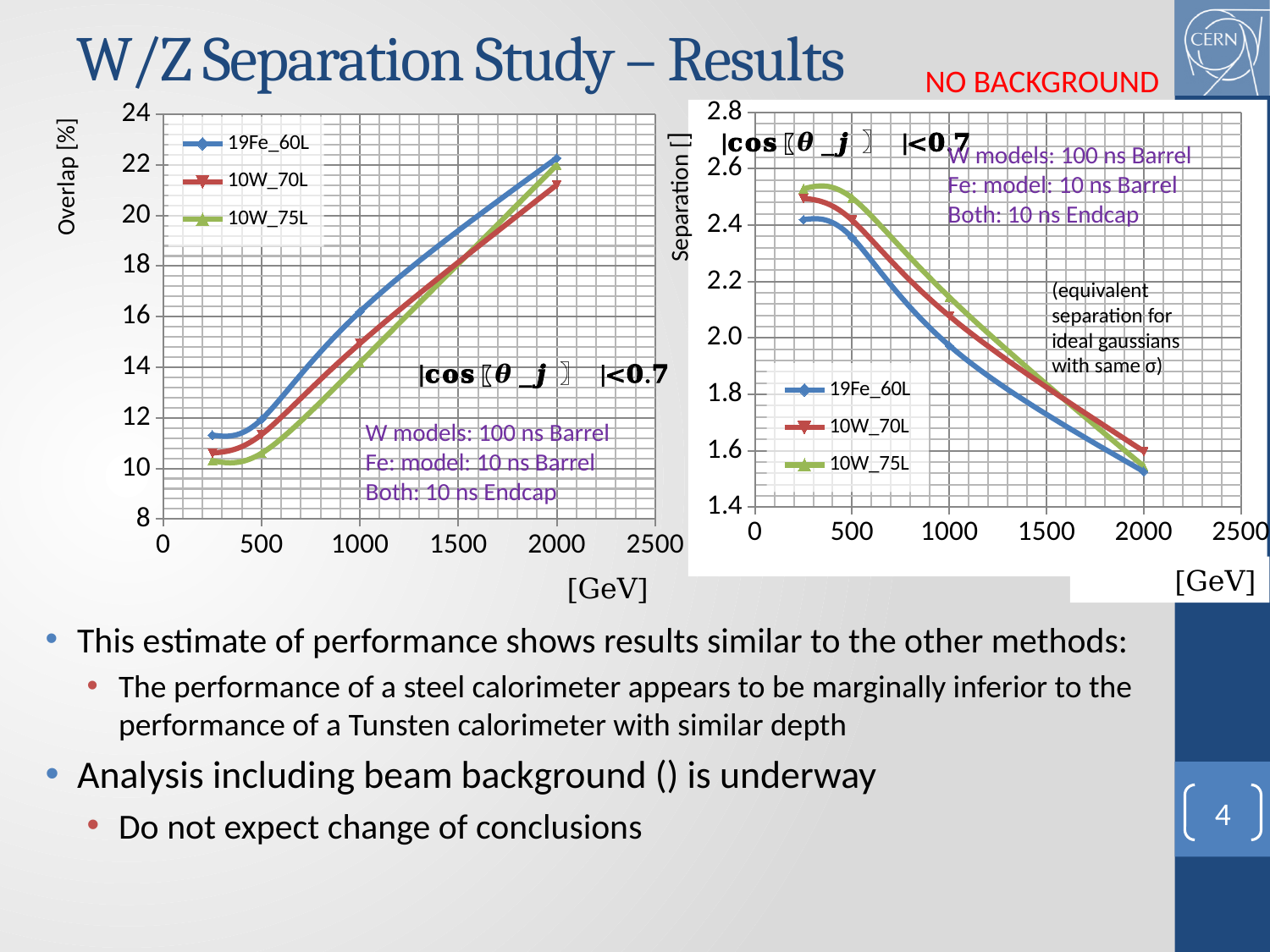
In the right chart (Separation), which series has the lowest value at 250 GeV? 19Fe_60L In the left chart (Overlap [%]), do the values rise or fall as energy in GeV increases? rise What is the y-axis label of the left chart? Overlap [%] In the right chart (Separation), is the value for 10W_70L at 250 GeV greater or less than 2.4? greater In the right chart (Separation), is the value for 19Fe_60L at 2000 GeV greater or less than 1.6? less In the left chart (Overlap [%]), which is larger at 1000 GeV: 19Fe_60L or 10W_75L? 19Fe_60L In the left chart (Overlap [%]), is the value for 10W_75L at 250 GeV greater or less than 12? less What kind of chart is the left chart (Overlap [%])? line chart In the right chart (Separation), which series has the highest value at 2000 GeV? 10W_70L How many series does the legend of the left chart (Overlap [%]) list? 3 In the right chart (Separation), do the values rise or fall as energy in GeV increases? fall